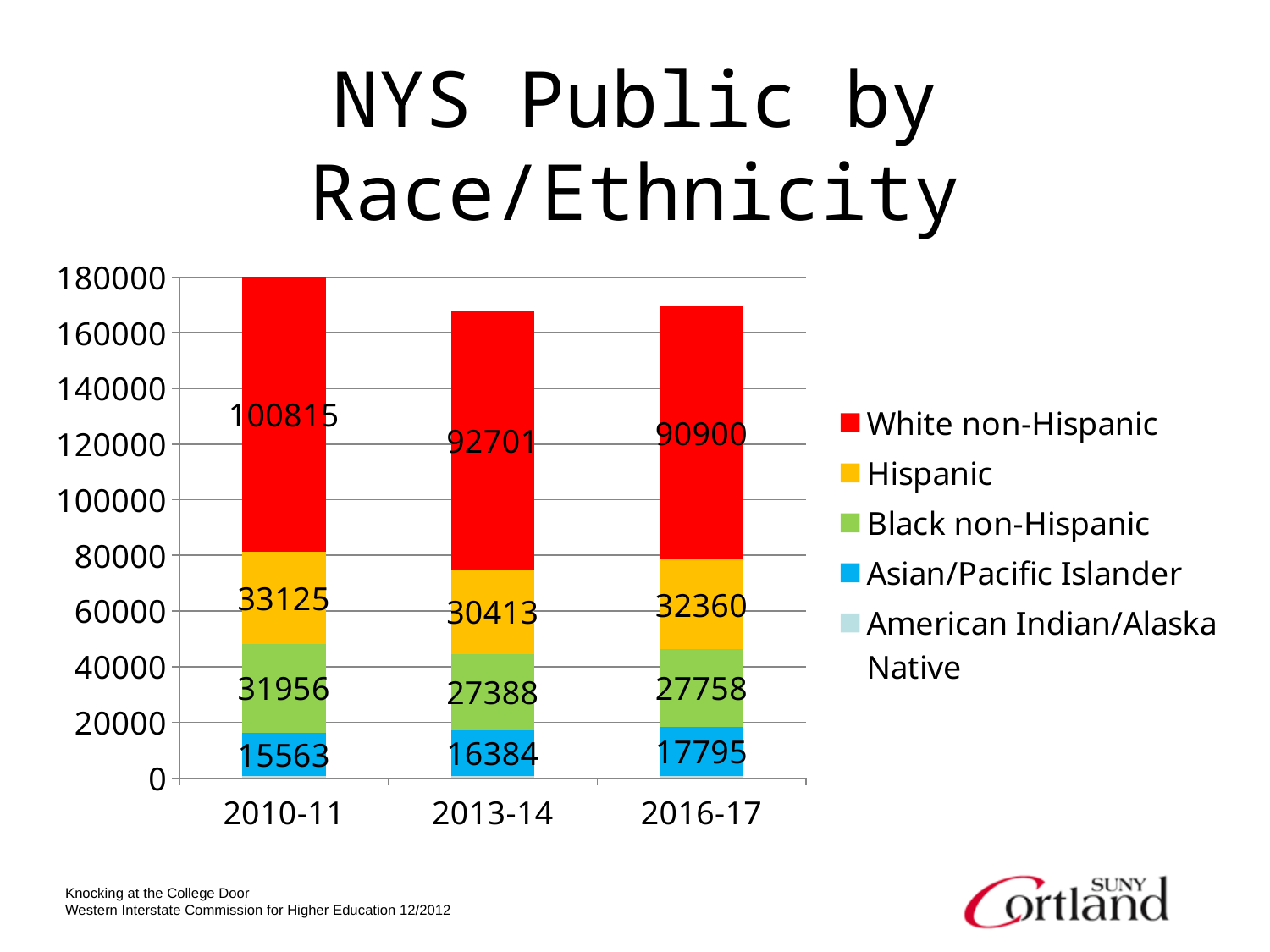
In which year is the Asian/Pacific Islander value lowest? 2010-11 How many years are shown on the x axis? 3 What is the value for Black non-Hispanic in 2013-14? 27388 What is the value for Asian/Pacific Islander in 2016-17? 17795 What is the value for Hispanic in 2013-14? 30413 What kind of chart is shown on the slide? Stacked bar chart What is the difference between the White non-Hispanic values for 2010-11 and 2016-17? 9915 Which is larger, the Hispanic value in 2016-17 or the Black non-Hispanic value in 2016-17? Hispanic In which year is the White non-Hispanic value highest? 2010-11 Is the total height of the 2013-14 stacked bar greater or less than 160000? greater What is the value for White non-Hispanic in 2010-11? 100815 How many series does the legend list? 5